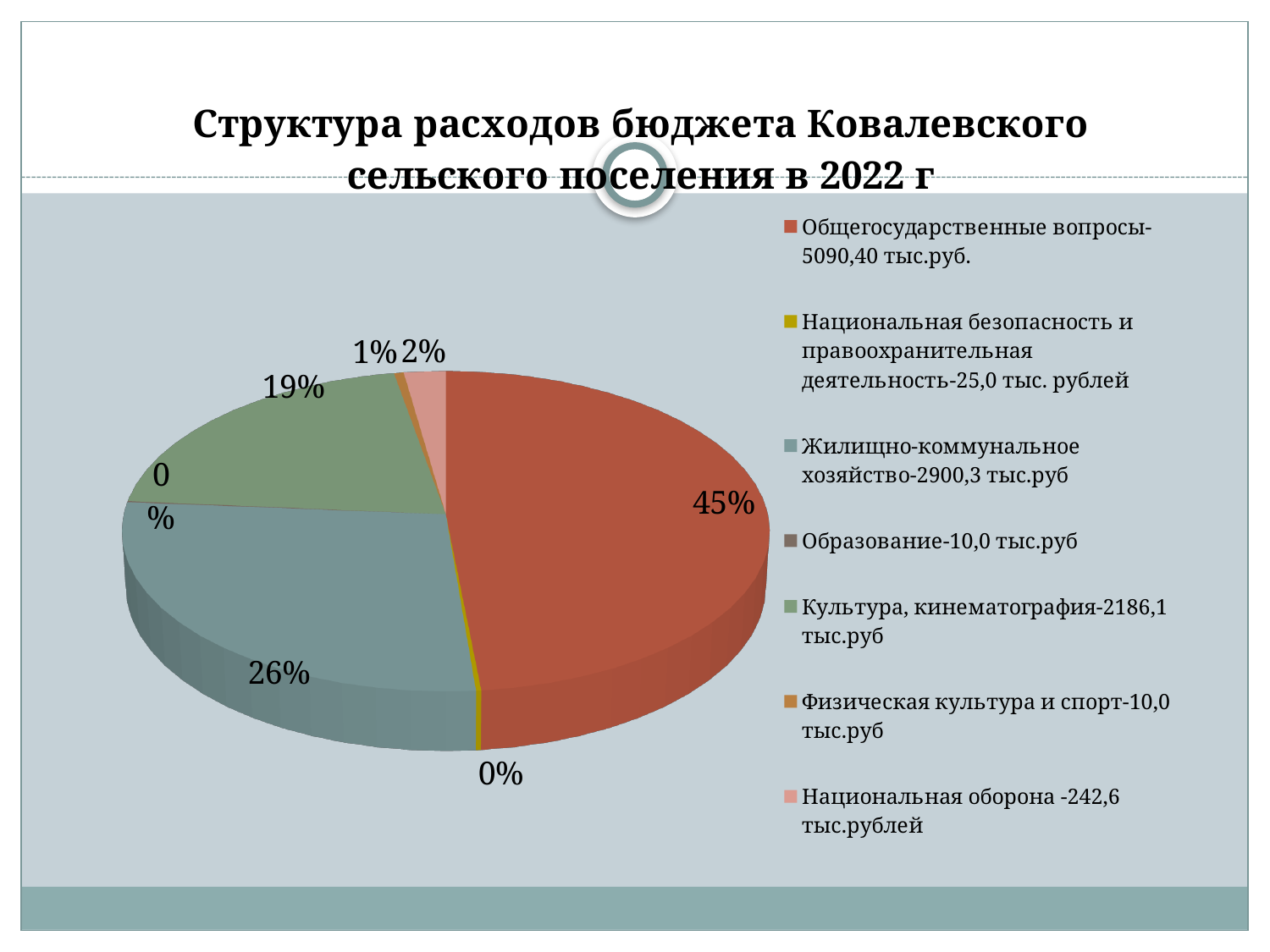
What share of the pie does Национальная оборона take? 2% What share of the pie does Культура, кинематография take? 19% What is the difference in percentage points between the Общегосударственные вопросы slice and the Жилищно-коммунальное хозяйство slice? 19% Which slice is larger: Жилищно-коммунальное хозяйство or Культура, кинематография? Жилищно-коммунальное хозяйство Which category has the largest slice of the pie? Общегосударственные вопросы What share of the pie does Жилищно-коммунальное хозяйство take? 26% What is the title of the chart? Структура расходов бюджета Ковалевского сельского поселения в 2022 г What amount in тыс.руб. does the legend give for Жилищно-коммунальное хозяйство? 2900,3 тыс.руб What kind of chart is shown on the slide? pie chart How many entries does the legend list? 7